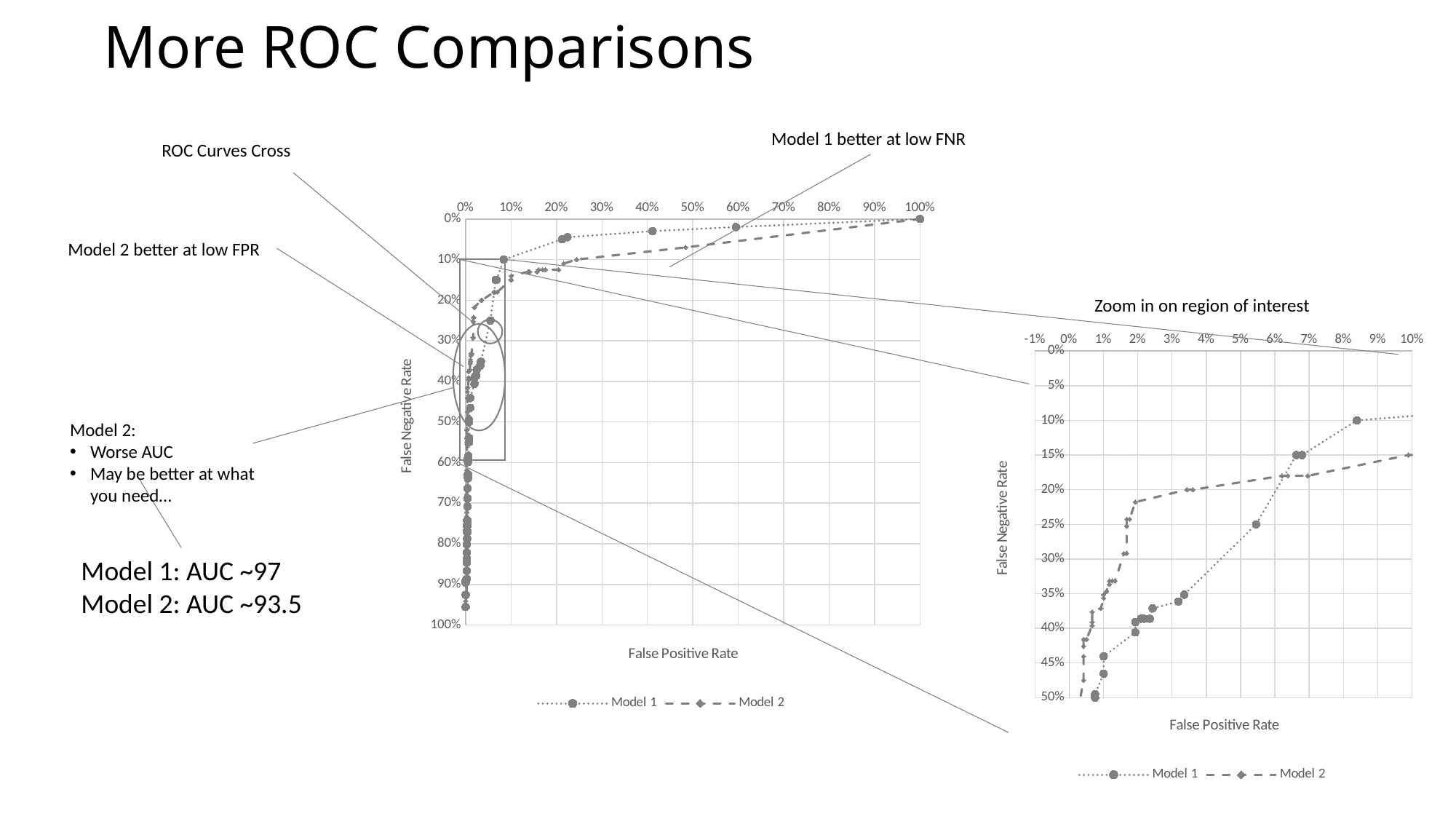
How many series does the legend of the main ROC chart list? 2 What is the x-axis title of the main ROC chart? False Positive Rate In the main ROC chart, is the False Negative Rate for Model 1 at a False Positive Rate of 40% greater or less than 10%? less What are the two series named in the legend of the zoomed chart on the right? Model 1 and Model 2 In the zoomed chart on the right, which model has the lower False Negative Rate at a False Positive Rate of 8%? Model 1 What kind of chart is the main ROC chart in the centre of the slide? Scatter (line) chart In the main ROC chart, is the False Negative Rate for Model 2 at a False Positive Rate of 60% greater or less than 10%? less In the zoomed chart on the right, is the False Negative Rate for Model 1 at a False Positive Rate of 2% greater or less than 30%? greater What is the highest value shown on the x axis of the zoomed chart on the right? 10% In the main ROC chart, does the False Negative Rate rise or fall as the False Positive Rate increases? Fall In the zoomed chart on the right, which model has the lower False Negative Rate at a False Positive Rate of 5%? Model 2